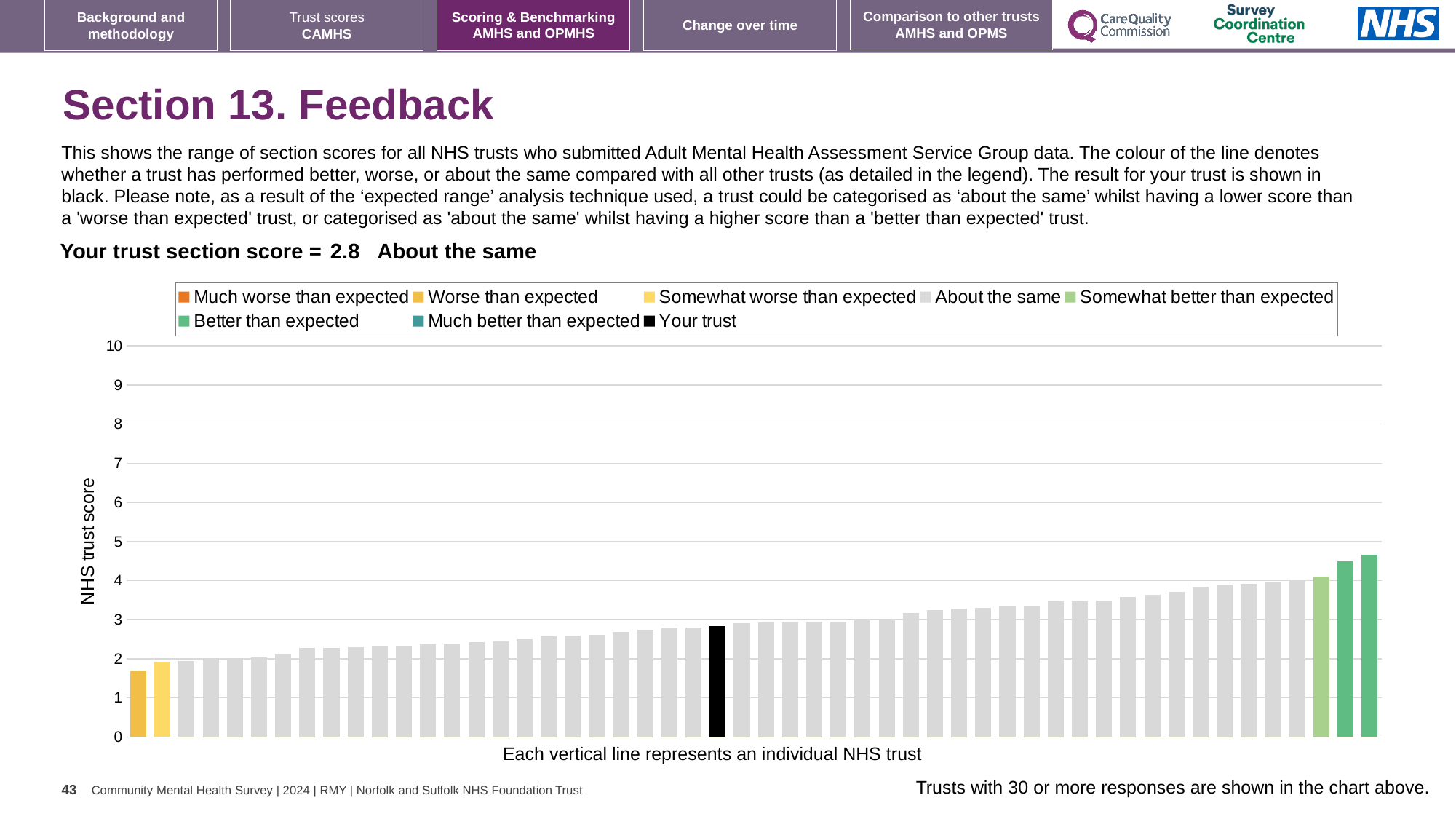
What is the title of the vertical axis? NHS trust score Which category is your trust's section score placed in? About the same What colour is the bar representing your trust? black What is the section score for your trust? 2.8 How many bars are coloured yellow (worse or somewhat worse than expected)? 2 Is the value of the tallest bar in the chart greater or less than 4? greater How many entries does the chart legend list? 8 Do the bar values rise or fall from left to right along the x axis? rise Is the value of the leftmost bar in the chart greater or less than 2? less How many bars are coloured green (somewhat better or better than expected)? 3 What kind of chart is shown on the slide? bar chart Is the value of the black 'Your trust' bar greater or less than 3? less